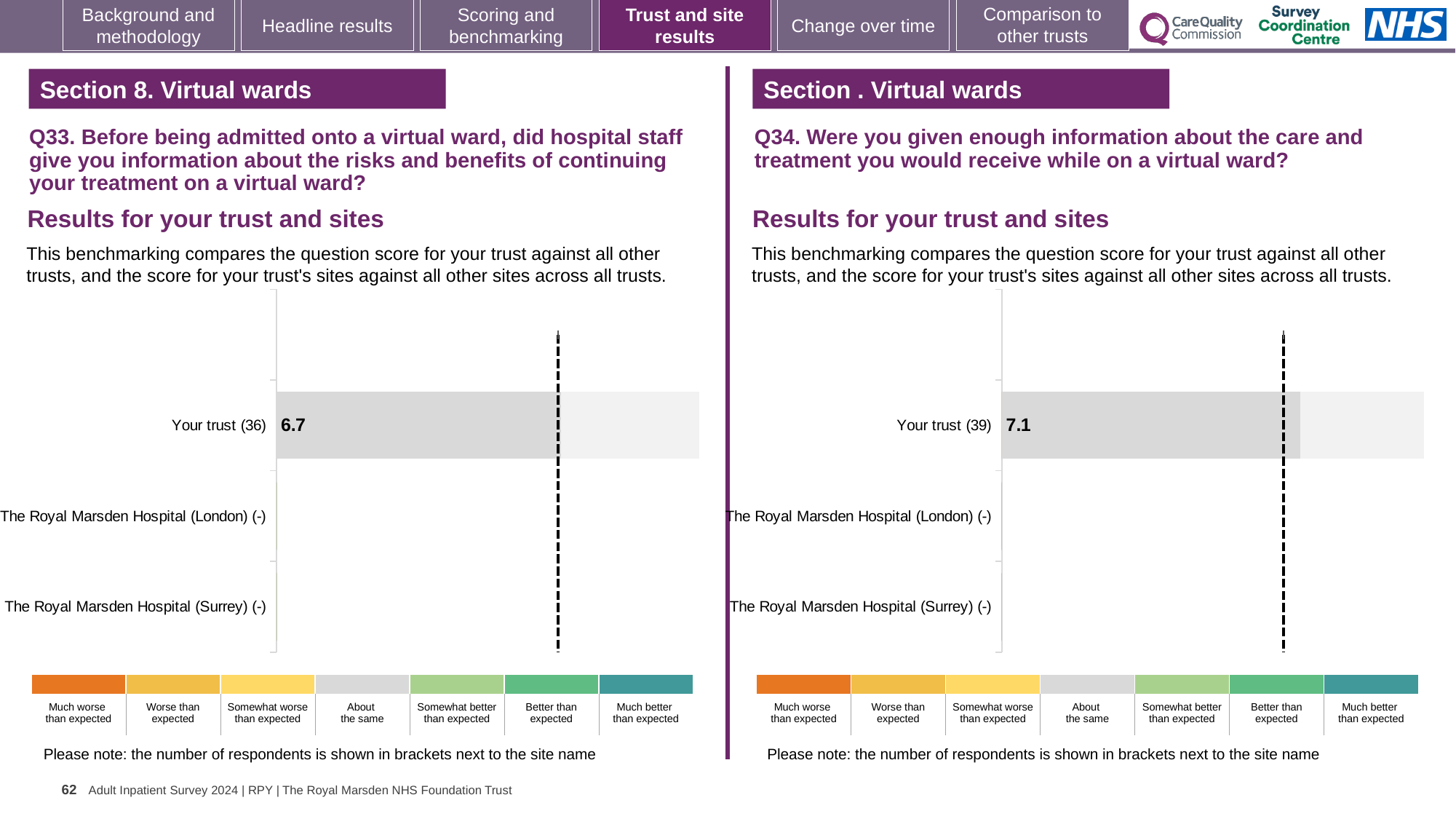
Which is larger: the Your trust score on the Q33 chart (left) or on the Q34 chart (right)? Q34 chart (right) How many categories (rows) are listed on the Q34 chart (right)? 3 On the Q34 chart (right), which category has the highest score shown? Your trust (39) On the Q33 chart (left), what is the score shown for Your trust? 6.7 What kind of chart is the Q33 chart (left)? Bar chart On the Q34 chart (right), what is the score shown for Your trust? 7.1 On the Q34 chart (right), how many respondents are shown in brackets for Your trust? 39 On the Q33 chart (left), how many respondents are shown in brackets for Your trust? 36 How many categories (rows) are listed on the Q33 chart (left)? 3 On the Q33 chart (left), what value is shown for The Royal Marsden Hospital (Surrey)? - How many benchmark bands are shown in the colour key below the Q33 chart (left)? 7 What is the difference between the Your trust score on the Q34 chart (right) and the Your trust score on the Q33 chart (left)? 0.4